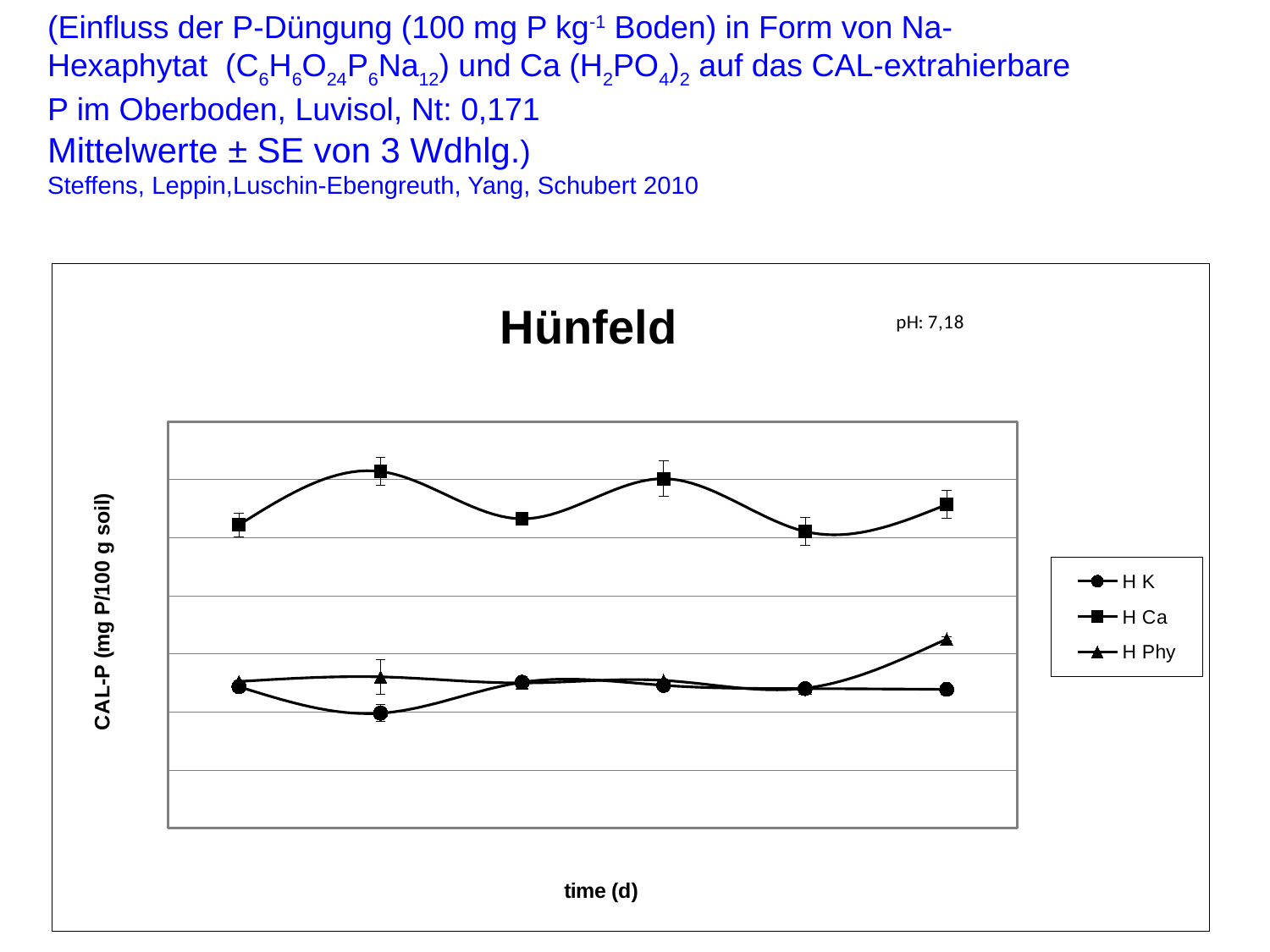
What kind of chart is shown on the slide? line chart What are the three series named in the legend of the chart? H K, H Ca, H Phy At the last time point, which series has the larger value, H Phy or H K? H Phy Which series has the highest values across the whole time range? H Ca How many series does the legend of the Hünfeld chart list? 3 Does the H Ca series rise or fall between the fourth and the fifth time point? fall At which time point (by position) does the H K series reach its lowest value? the second What is the title of the chart? Hünfeld At the first time point, which series has the larger value, H Ca or H K? H Ca Does the H Phy series rise or fall between the fifth and the last time point? rise How many data points are plotted for the H Ca series? 6 At which time point (by position) does the H Phy series reach its highest value? the last (sixth)